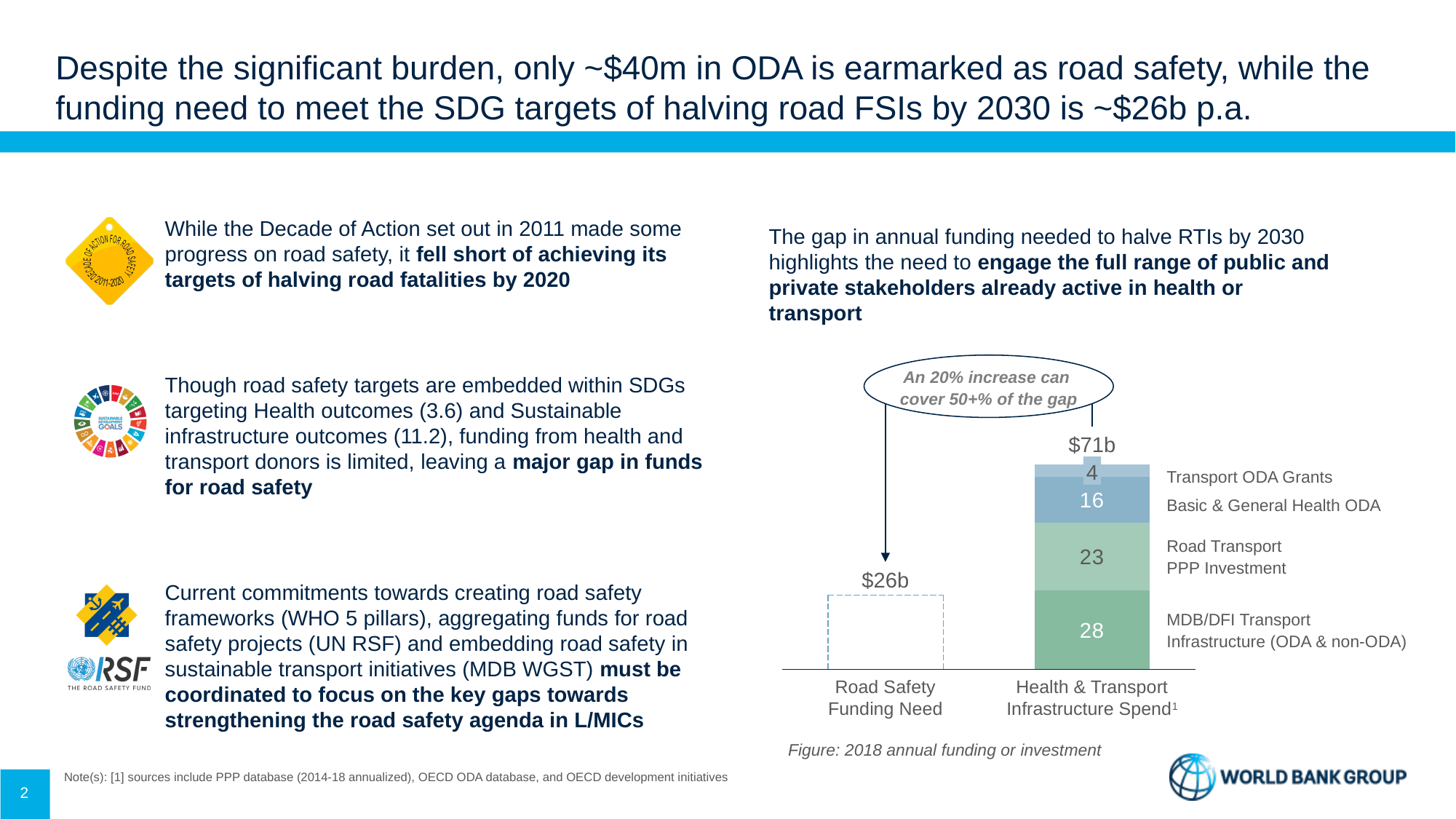
How many segments make up the Health & Transport Infrastructure Spend bar? 4 Which segment of the Health & Transport Infrastructure Spend bar is the largest? MDB/DFI Transport Infrastructure (ODA & non-ODA) What is the value of the MDB/DFI Transport Infrastructure (ODA & non-ODA) segment? 28 What is the total value shown for Health & Transport Infrastructure Spend? $71b What is the value of the Transport ODA Grants segment? 4 What is the difference between the Health & Transport Infrastructure Spend total and the Road Safety Funding Need? $45b What is the value of the Road Transport PPP Investment segment? 23 What is the value of the Basic & General Health ODA segment? 16 What does the callout above the chart say a 20% increase can cover? 50+% of the gap What is the value shown for Road Safety Funding Need? $26b What kind of chart is shown on the slide? Stacked bar chart Which segment of the Health & Transport Infrastructure Spend bar is the smallest? Transport ODA Grants